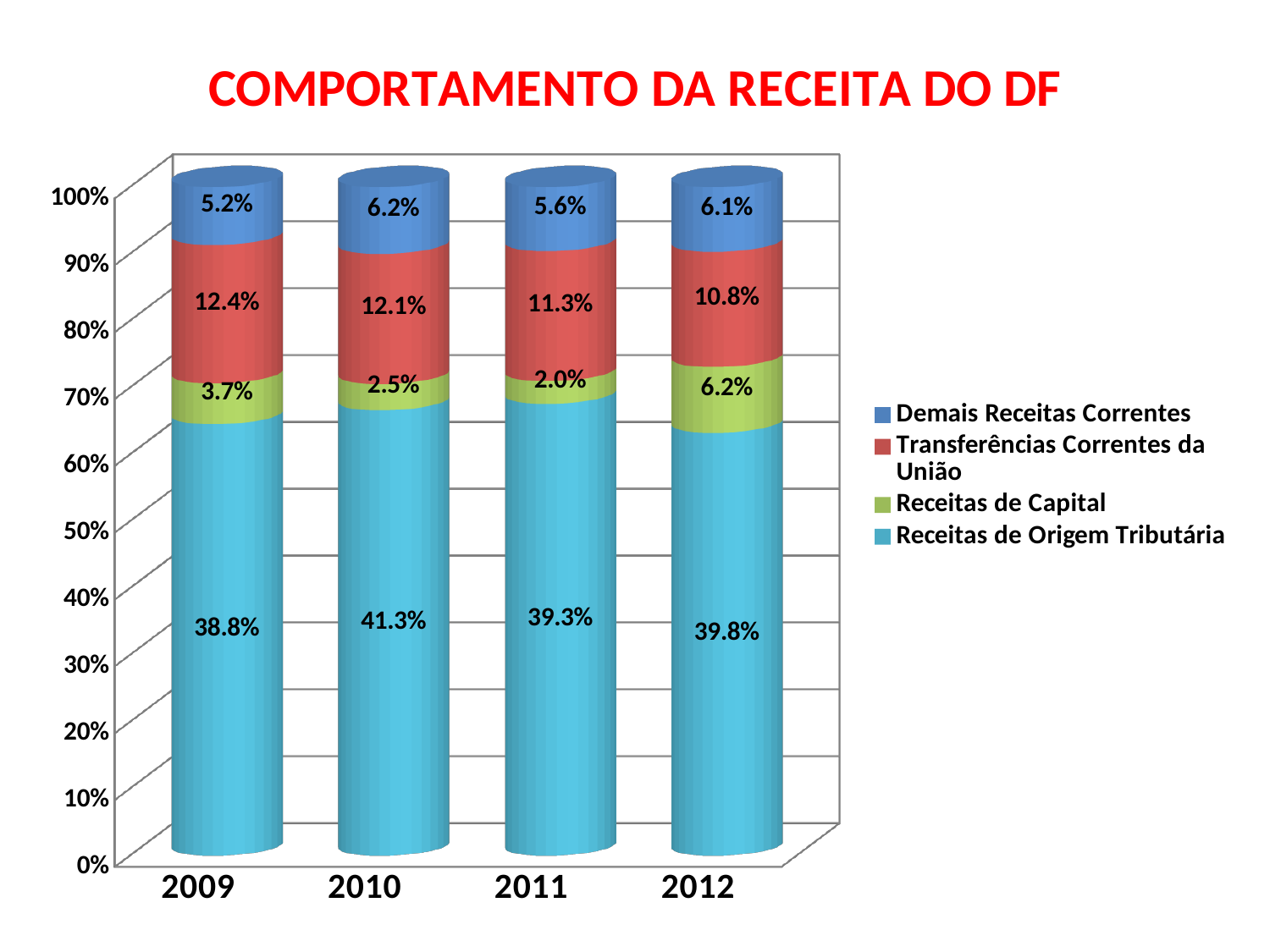
What is the value for Receitas de Origem Tributária in 2010? 41.3% Which is larger: Demais Receitas Correntes in 2010 or in 2011? 2010 What is the value for Receitas de Capital in 2011? 2.0% What is the value for Transferências Correntes da União in 2012? 10.8% How many series does the legend list? 4 Does Transferências Correntes da União rise or fall from 2009 to 2012? Fall In which year is Receitas de Origem Tributária highest? 2010 How many years are shown on the x axis? 4 What kind of chart is shown on the slide? Stacked bar chart What is the value for Demais Receitas Correntes in 2009? 5.2% What is the difference between Transferências Correntes da União in 2009 and in 2012? 1.6% In which year is Receitas de Capital lowest? 2011